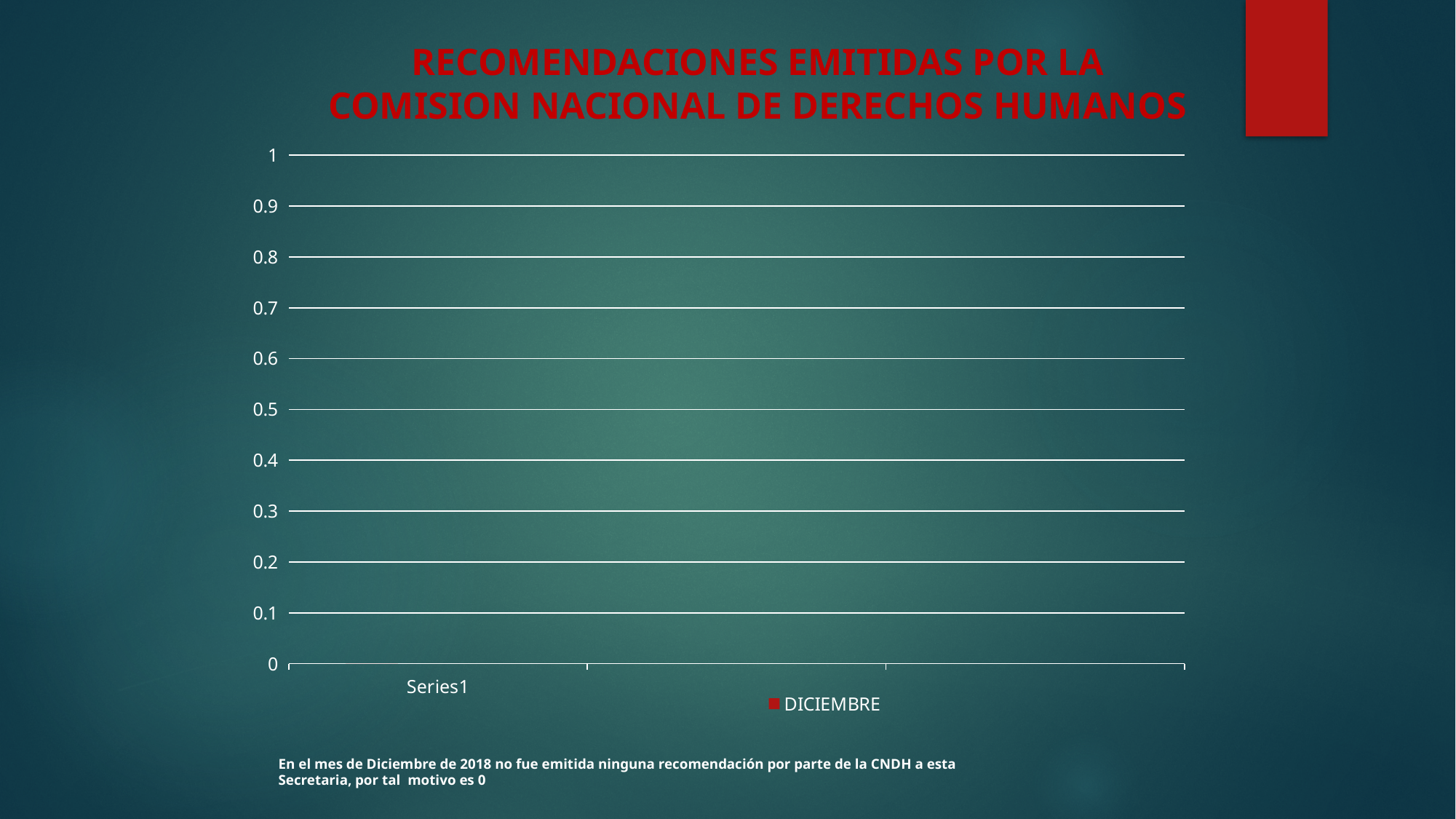
Is the value for Series1 greater or less than 0.5? less What is the title of the chart? RECOMENDACIONES EMITIDAS POR LA COMISION NACIONAL DE DERECHOS HUMANOS What series name appears in the legend? DICIEMBRE How many categories are shown on the x axis? 1 How many series does the legend list? 1 What is the label of the single category on the x axis? Series1 What is the highest value shown on the y axis? 1 What is the value for Series1 in the DICIEMBRE series? 0